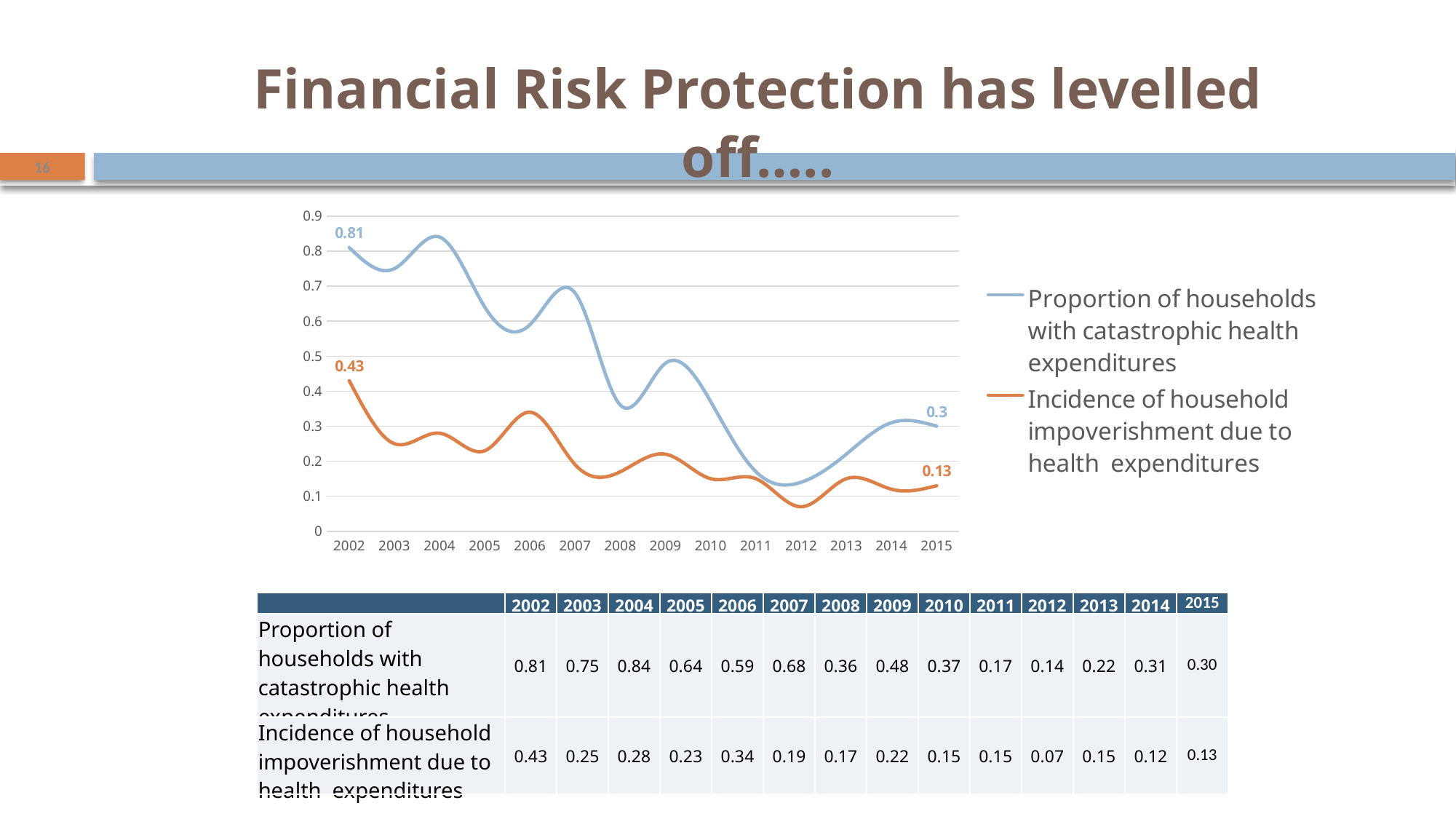
What is the labelled value for Incidence of household impoverishment due to health expenditures in 2002? 0.43 What is the labelled value for Proportion of households with catastrophic health expenditures in 2002? 0.81 Which series has the higher value in 2002, Proportion of households with catastrophic health expenditures or Incidence of household impoverishment due to health expenditures? Proportion of households with catastrophic health expenditures How many years are plotted along the x axis of the chart? 14 What type of chart is shown on the slide? line chart Is the value for Proportion of households with catastrophic health expenditures in 2004 greater or less than 0.8? greater What is the labelled value for Incidence of household impoverishment due to health expenditures in 2015? 0.13 What colour is the line for Incidence of household impoverishment due to health expenditures? orange What is the labelled value for Proportion of households with catastrophic health expenditures in 2015? 0.3 How many series does the chart legend list? 2 Overall, do the values for Proportion of households with catastrophic health expenditures rise or fall from 2002 to 2015? fall What is the difference between the 2002 and 2015 values for Proportion of households with catastrophic health expenditures? 0.51